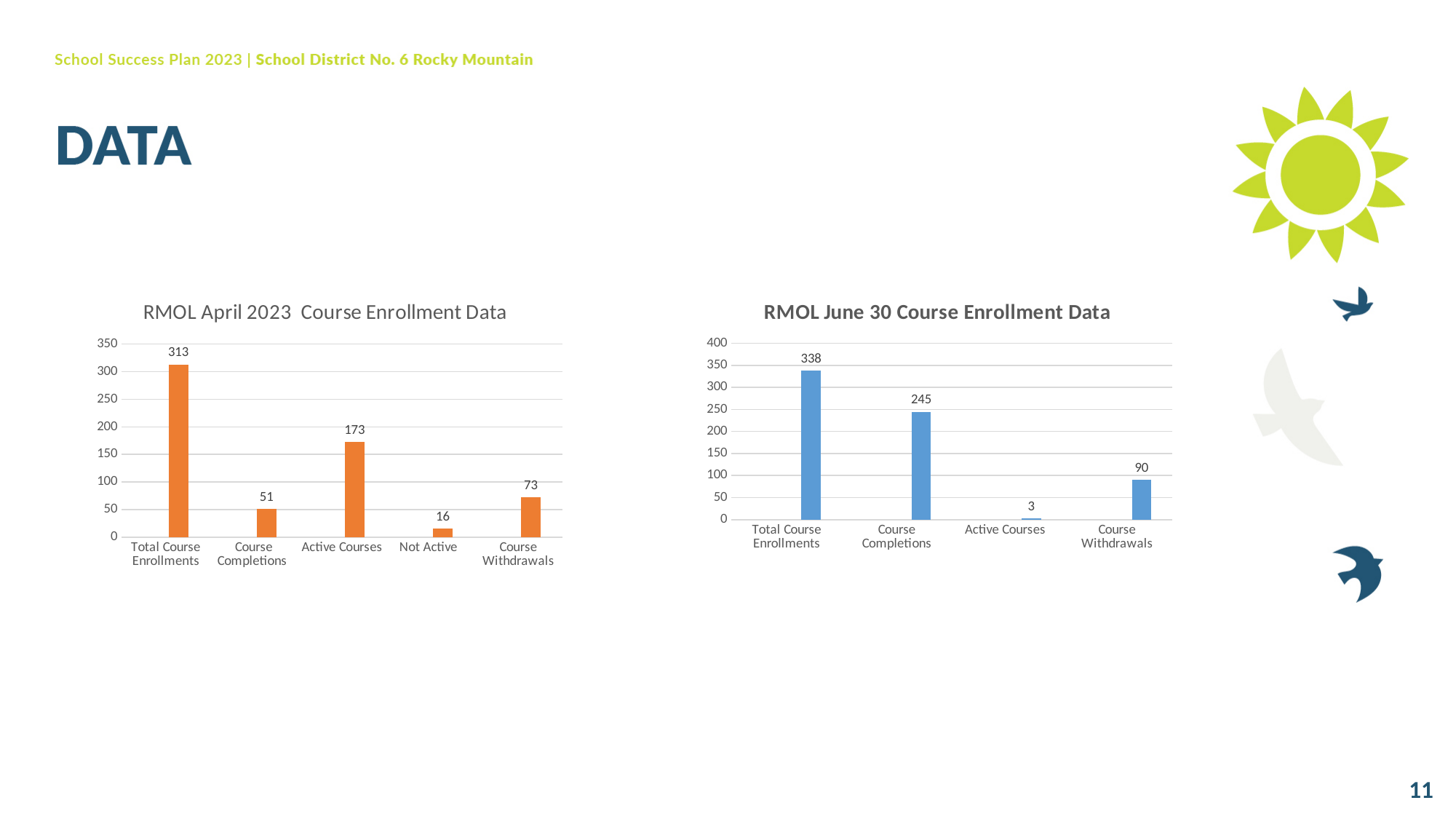
How many categories are shown in the RMOL April 2023 Course Enrollment Data chart? 5 What colour are the bars in the RMOL April 2023 Course Enrollment Data chart? Orange In the RMOL June 30 Course Enrollment Data chart, is the value for Course Withdrawals greater or less than 100? less How many categories are shown in the RMOL June 30 Course Enrollment Data chart? 4 What kind of chart is the RMOL June 30 Course Enrollment Data chart? Bar chart In the RMOL April 2023 Course Enrollment Data chart, what is the value for Total Course Enrollments? 313 In the RMOL April 2023 Course Enrollment Data chart, which category has the lowest value? Not Active In the RMOL June 30 Course Enrollment Data chart, what is the difference between Total Course Enrollments and Course Completions? 93 In the RMOL June 30 Course Enrollment Data chart, what is the value for Course Completions? 245 In the RMOL June 30 Course Enrollment Data chart, which category has the highest value? Total Course Enrollments In the RMOL April 2023 Course Enrollment Data chart, which is larger, Course Withdrawals or Course Completions? Course Withdrawals In the RMOL April 2023 Course Enrollment Data chart, what is the difference between Active Courses and Course Completions? 122